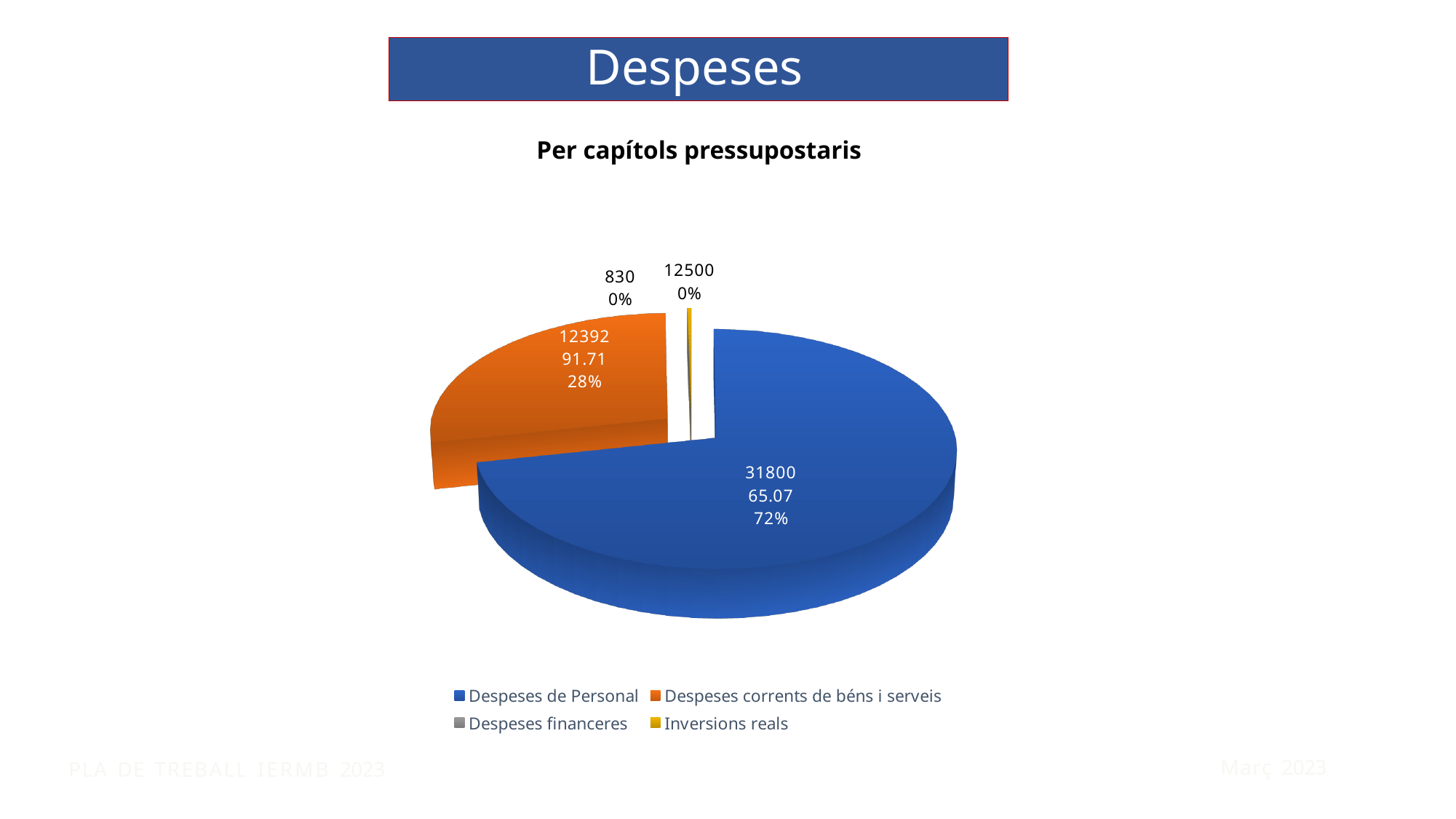
What share of the pie does Despeses de Personal represent? 72% What colour is the slice for Despeses corrents de béns i serveis? orange Which is larger, the slice for Despeses de Personal or the slice for Despeses corrents de béns i serveis? Despeses de Personal What kind of chart is shown on the slide? pie chart What percentage is shown for Despeses financeres? 0% What share of the pie does Despeses corrents de béns i serveis represent? 28% How many categories does the legend of the pie chart list? 4 What is the title of the chart? Per capítols pressupostaris Which category has the largest slice of the pie? Despeses de Personal What is the difference in percentage points between the Despeses de Personal share and the Despeses corrents de béns i serveis share? 44